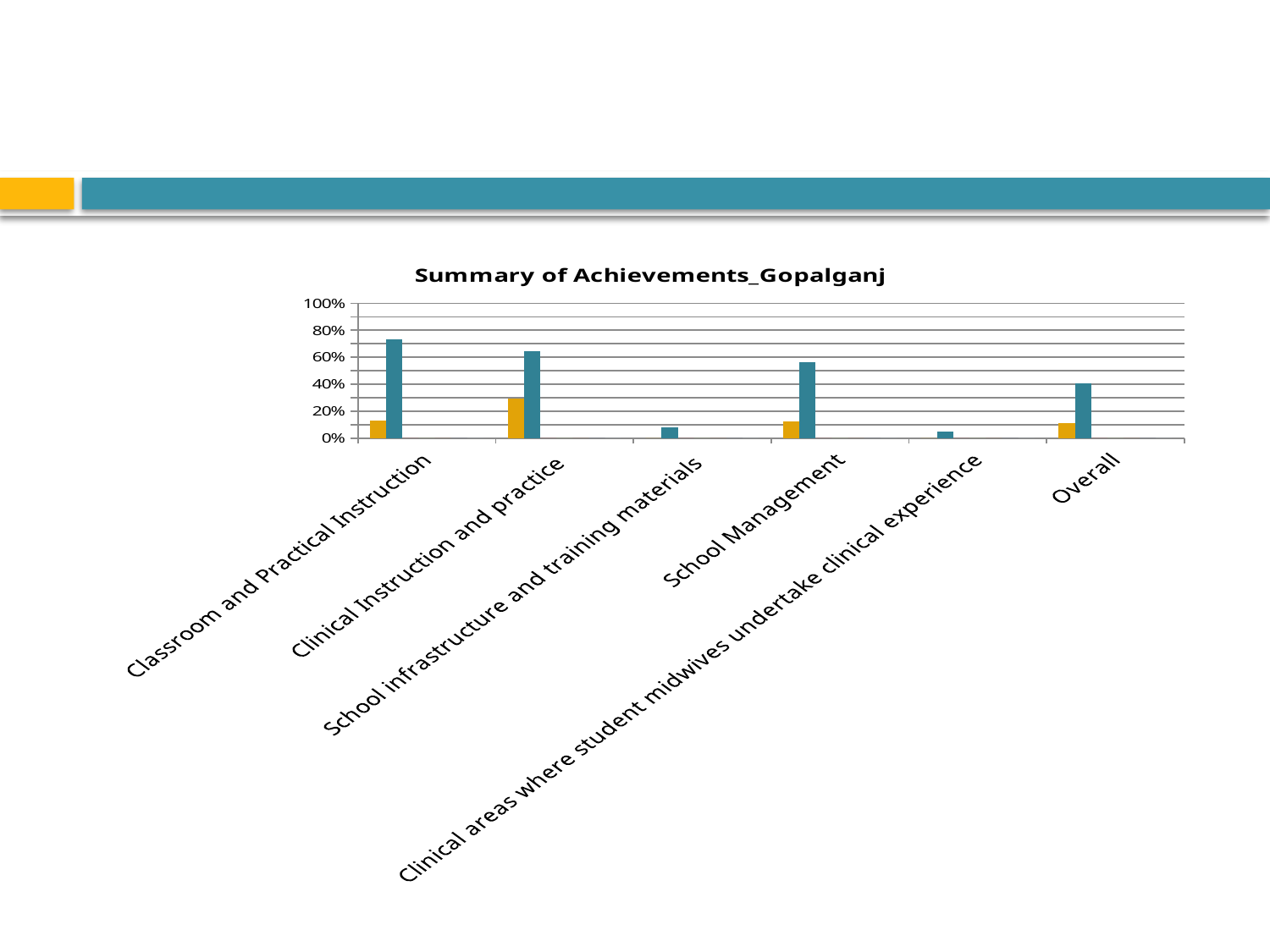
Is the teal bar for Classroom and Practical Instruction greater or less than 60%? greater Which category has the tallest orange bar? Clinical Instruction and practice What type of chart is shown on the slide? bar chart Which category has the shortest teal bar? Clinical areas where student midwives undertake clinical experience Which is larger for Overall, the teal bar or the orange bar? teal bar Is the teal bar for School Management greater or less than 40%? greater Is the orange bar for Clinical Instruction and practice greater or less than 20%? greater How many categories are shown on the x axis of the chart? 6 Which category has a taller teal bar, Classroom and Practical Instruction or School Management? Classroom and Practical Instruction What is the title of the chart? Summary of Achievements_Gopalganj Which category has the tallest teal bar? Classroom and Practical Instruction